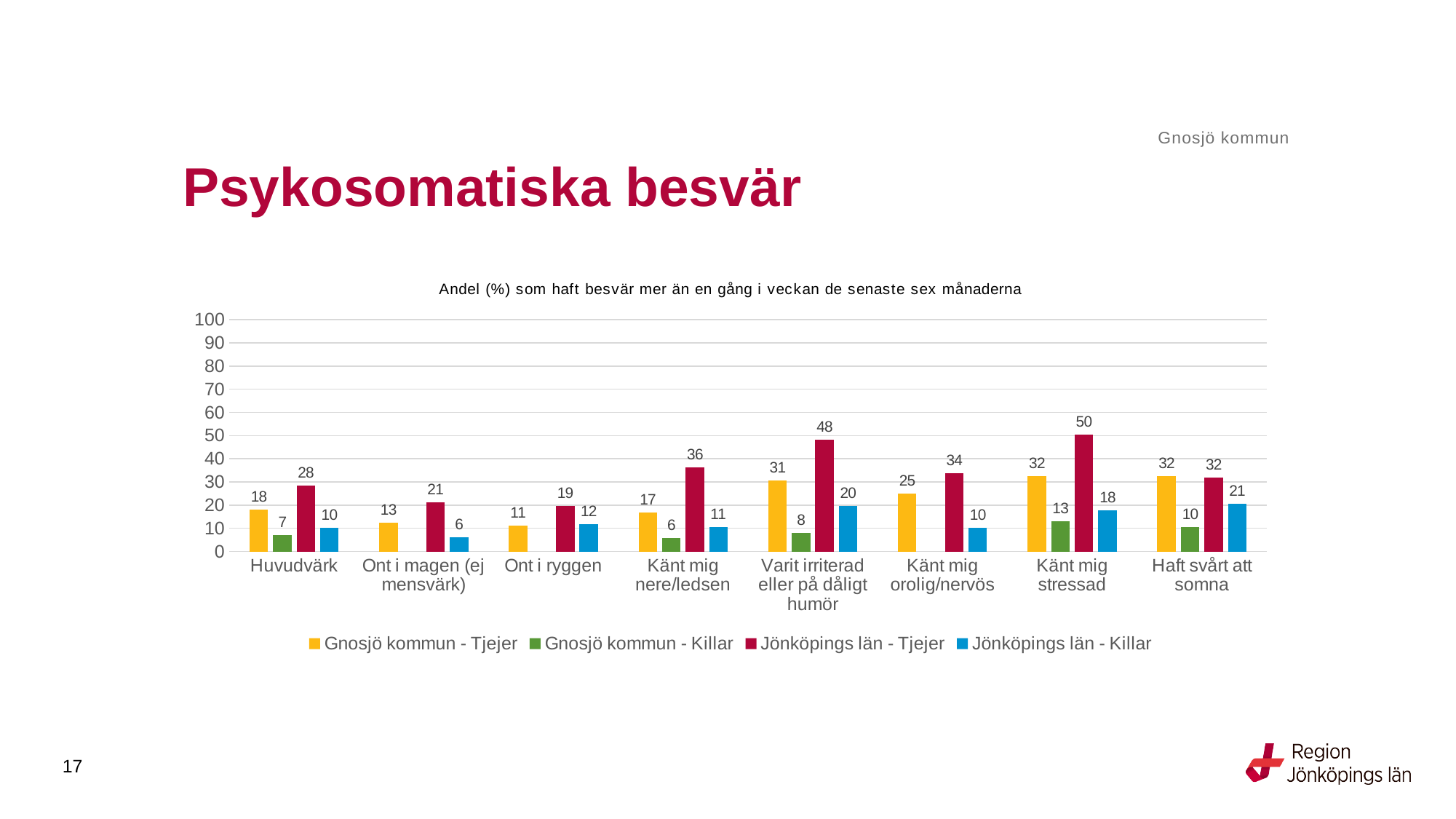
How many series does the legend list? 4 What kind of chart is shown on the slide? bar chart What is the value for Jönköpings län - Killar for Haft svårt att somna? 21 How many categories are shown on the x axis? 8 What is the difference between Jönköpings län - Tjejer and Gnosjö kommun - Tjejer for Känt mig nere/ledsen? 19 What is the value for Gnosjö kommun - Killar for Huvudvärk? 7 For which category is the Jönköpings län - Tjejer value highest? Känt mig stressad Is the value for Jönköpings län - Tjejer for Varit irriterad eller på dåligt humör greater or less than 40? greater For which category is the Jönköpings län - Killar value lowest? Ont i magen (ej mensvärk) What is the value for Jönköpings län - Tjejer for Känt mig stressad? 50 What is the value for Gnosjö kommun - Tjejer for Varit irriterad eller på dåligt humör? 31 Which is larger for Ont i ryggen: Gnosjö kommun - Tjejer or Jönköpings län - Killar? Jönköpings län - Killar